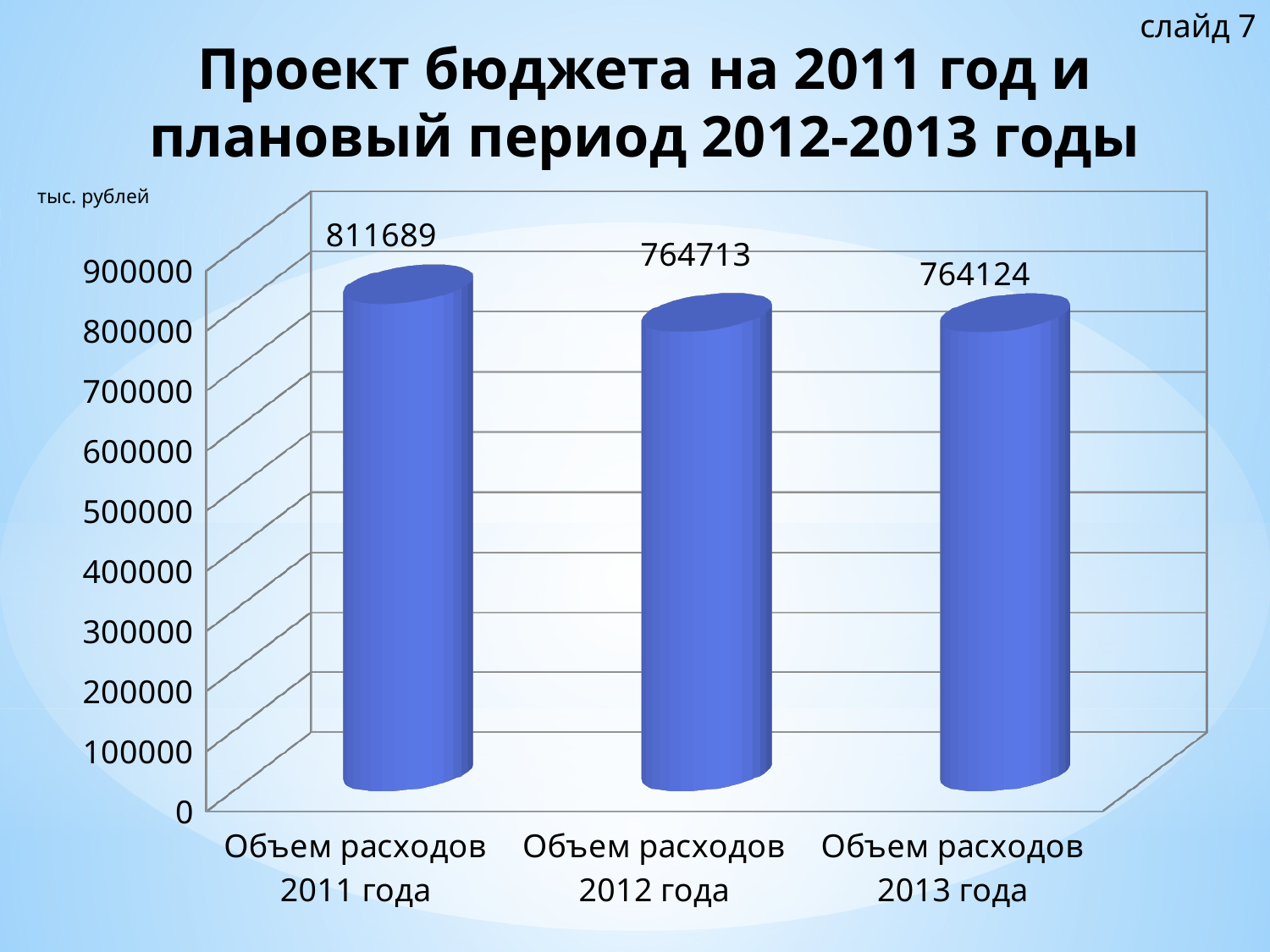
What is the value for Объем расходов 2013 года? 764124 In what units are the values on the chart expressed? тыс. рублей What is the difference between the values for Объем расходов 2011 года and Объем расходов 2012 года? 46976 Which is larger, the value for Объем расходов 2011 года or Объем расходов 2013 года? Объем расходов 2011 года Do the values rise or fall from 2011 to 2013 along the x axis? fall What is the value for Объем расходов 2011 года? 811689 How many bars are shown in the chart? 3 What kind of chart is shown on the slide? bar chart Is the value for Объем расходов 2012 года greater or less than 800000? less Which category has the highest value? Объем расходов 2011 года What is the value for Объем расходов 2012 года? 764713 What is the difference between the values for Объем расходов 2012 года and Объем расходов 2013 года? 589